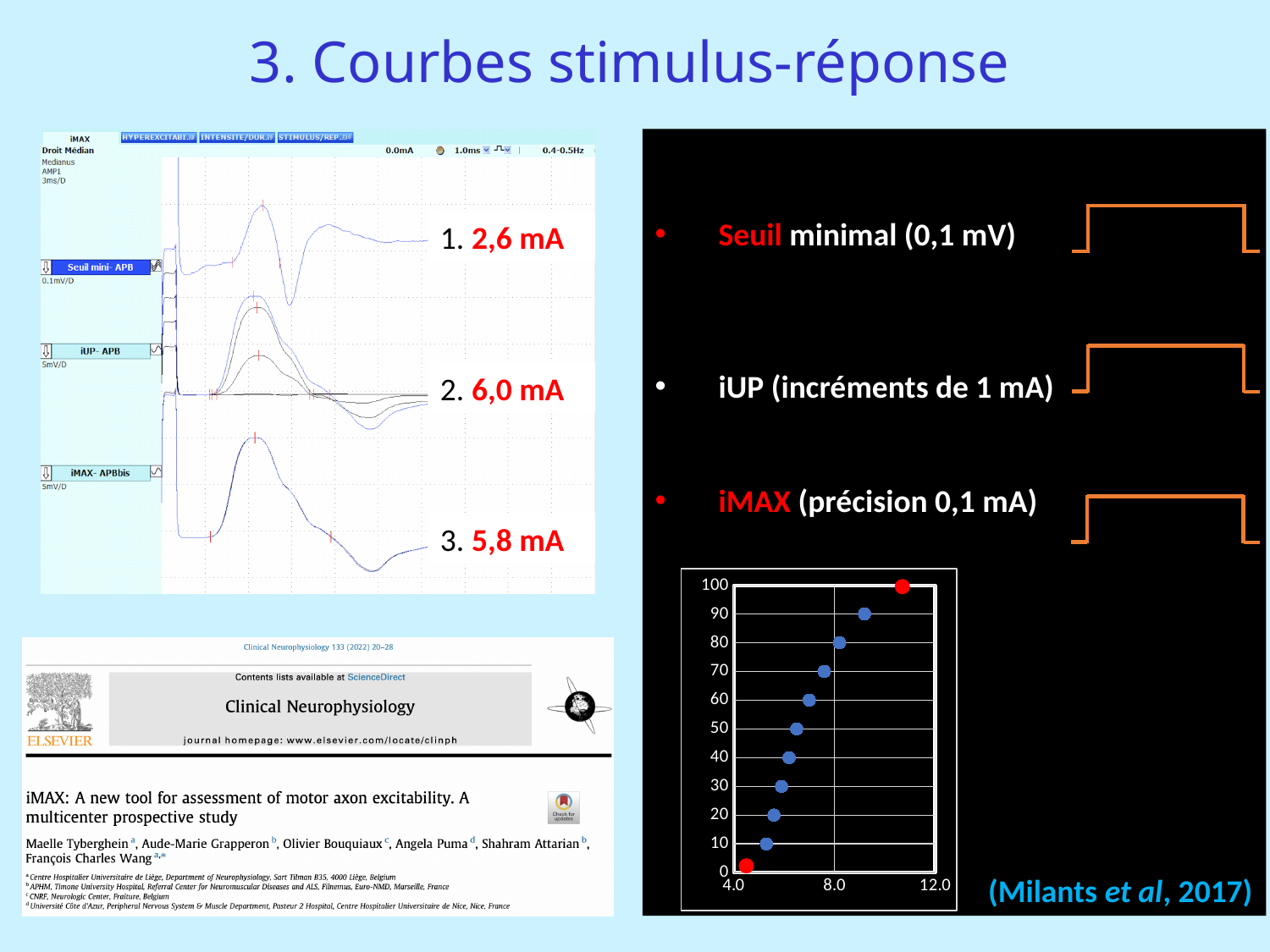
In the scatter chart at the bottom right, how many data points are plotted? 11 What kind of chart is shown at the bottom right of the slide? scatter chart In the scatter chart at the bottom right, what are the three tick labels shown on the x axis? 4.0, 8.0, 12.0 In the scatter chart at the bottom right, is the x value of the point at y = 90 greater or less than 8.0? greater In the scatter chart at the bottom right, is the x value of the point at y = 50 greater or less than 8.0? less In the scatter chart at the bottom right, which point has the highest y value: the red point at the top or the red point at the bottom? the red point at the top In the scatter chart at the bottom right, what is the highest value shown on the y axis? 100 In the scatter chart at the bottom right, is the x value of the point at y = 100 greater or less than 8.0? greater In the scatter chart at the bottom right, what is the highest y value at which a point is plotted? 100 In the scatter chart at the bottom right, do the y values rise or fall as the x values increase? rise In the scatter chart at the bottom right, what is the lowest y value at which a point is plotted? 0